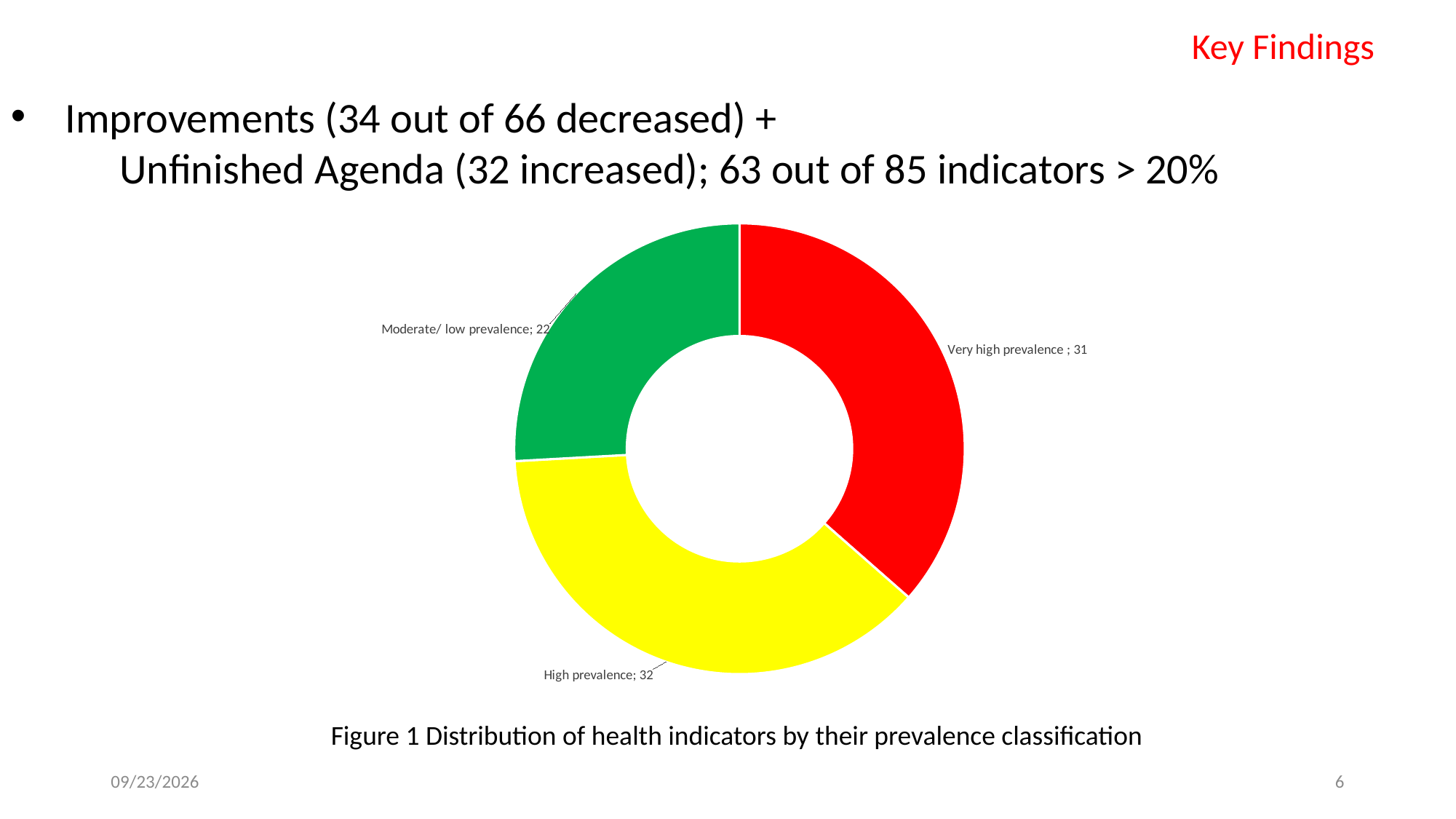
What is the total number of indicators across all three categories in the chart? 85 Which has more indicators: Very high prevalence or Moderate/ low prevalence? Very high prevalence How many indicators are classified as High prevalence? 32 What is the difference between the number of High prevalence indicators and Moderate/ low prevalence indicators? 10 What kind of chart is shown on the slide? Doughnut chart What is the difference between the number of Very high prevalence indicators and Moderate/ low prevalence indicators? 9 Which prevalence category has the fewest indicators? Moderate/ low prevalence How many categories does the chart show? 3 How many indicators are classified as Moderate/ low prevalence? 22 How many indicators are classified as Very high prevalence? 31 What colour is the Very high prevalence slice? Red